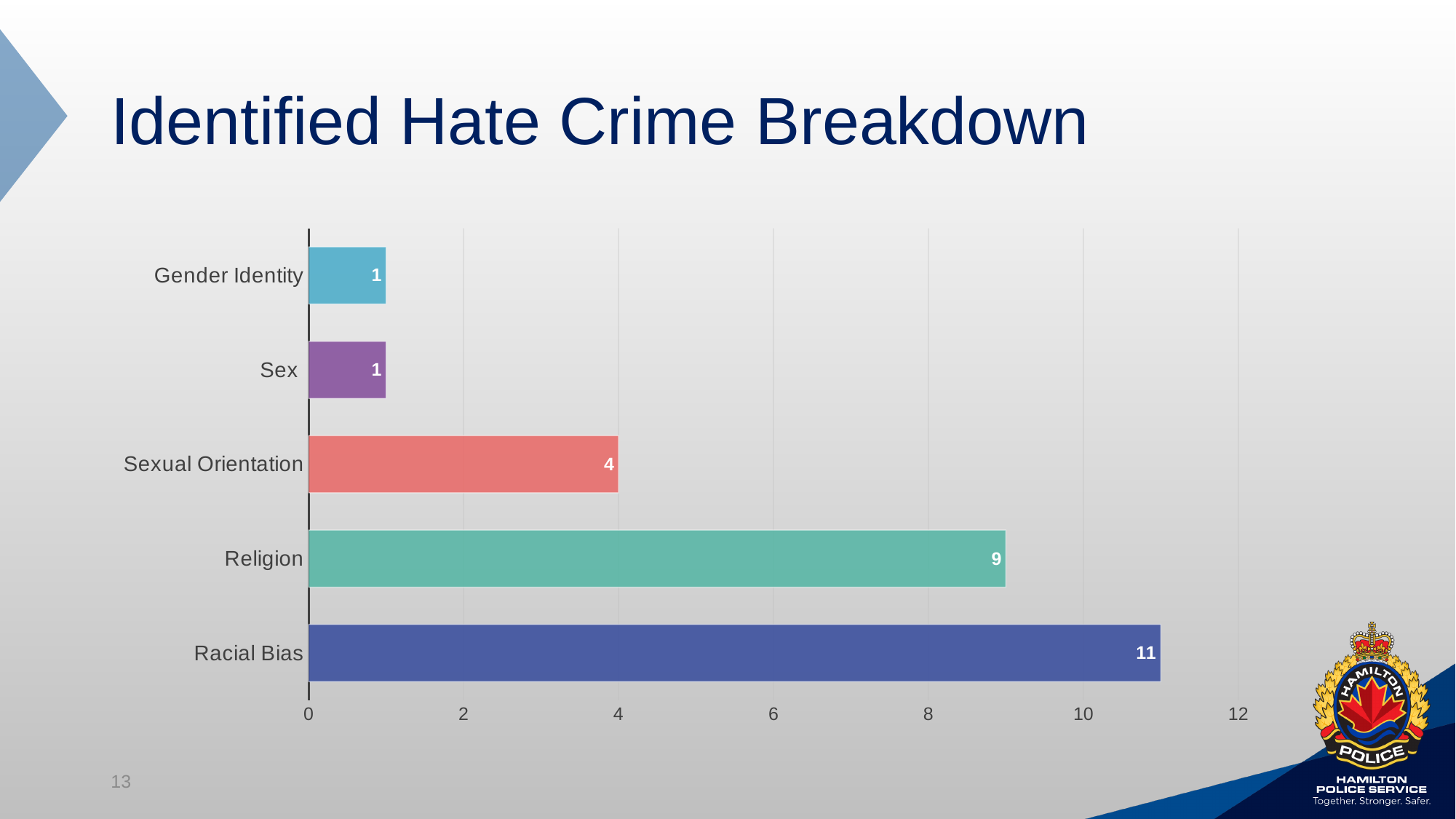
What is the title of the slide containing the chart? Identified Hate Crime Breakdown What kind of chart is shown on the slide? Bar chart How many categories are shown in the chart? 5 What is the value for Religion? 9 Which category has the highest value? Racial Bias What is the value for Gender Identity? 1 What is the value for Racial Bias? 11 What is the value for Sexual Orientation? 4 Is the value for Religion greater or less than 8? greater What is the difference between the values for Racial Bias and Religion? 2 What is the difference between the values for Religion and Sexual Orientation? 5 Which is larger, the value for Sexual Orientation or the value for Sex? Sexual Orientation